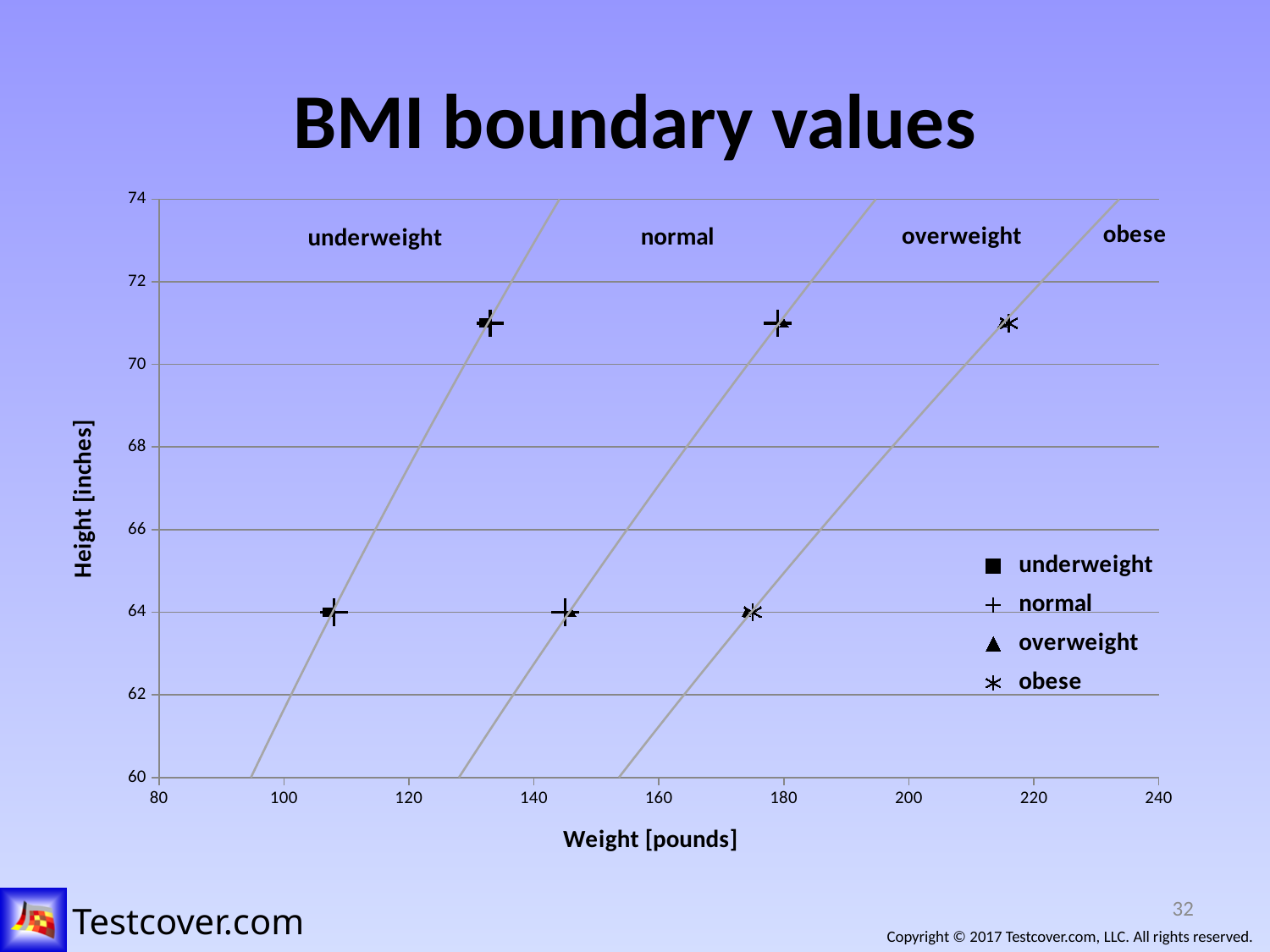
Is the weight of the leftmost cluster of points at height 64 greater or less than 100? greater How many series does the legend list? 4 What is the label of the x axis? Weight [pounds] How many boundary lines separate the BMI regions on the chart? 3 What kind of chart is shown on the slide? scatter chart Is the weight of the rightmost cluster of points at height 64 greater or less than 160? greater At what height (in inches) does the lower row of plotted points lie? 64 Is the weight of the middle cluster of points in the upper row greater or less than 200? less What is the title of the chart? BMI boundary values Which has the larger weight: the rightmost cluster of points in the upper row or the rightmost cluster in the lower row? the upper row